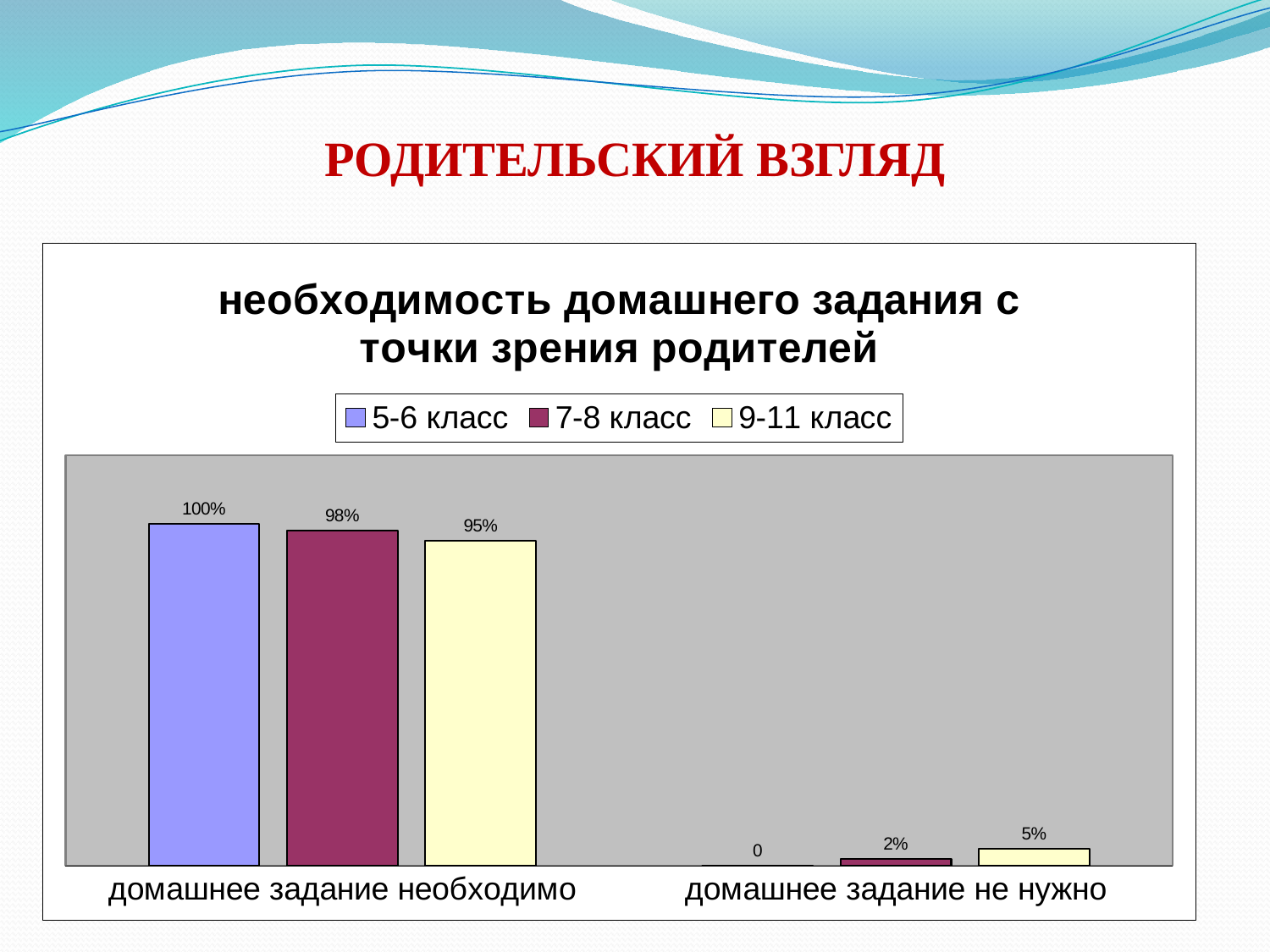
What is the difference between the 9-11 класс and 7-8 класс values in the category "домашнее задание не нужно"? 3% How many categories are shown on the x axis? 2 What is the value for 5-6 класс in the category "домашнее задание необходимо"? 100% What kind of chart is shown on the slide? Bar chart What is the value for 9-11 класс in the category "домашнее задание не нужно"? 5% Which series has the lowest value in the category "домашнее задание не нужно"? 5-6 класс Which is larger: the 7-8 класс value or the 9-11 класс value in the category "домашнее задание необходимо"? 7-8 класс Which series has the highest value in the category "домашнее задание необходимо"? 5-6 класс What is the value for 5-6 класс in the category "домашнее задание не нужно"? 0 What is the value for 7-8 класс in the category "домашнее задание необходимо"? 98% How many series does the legend list? 3 What is the difference between the 5-6 класс and 9-11 класс values in the category "домашнее задание необходимо"? 5%